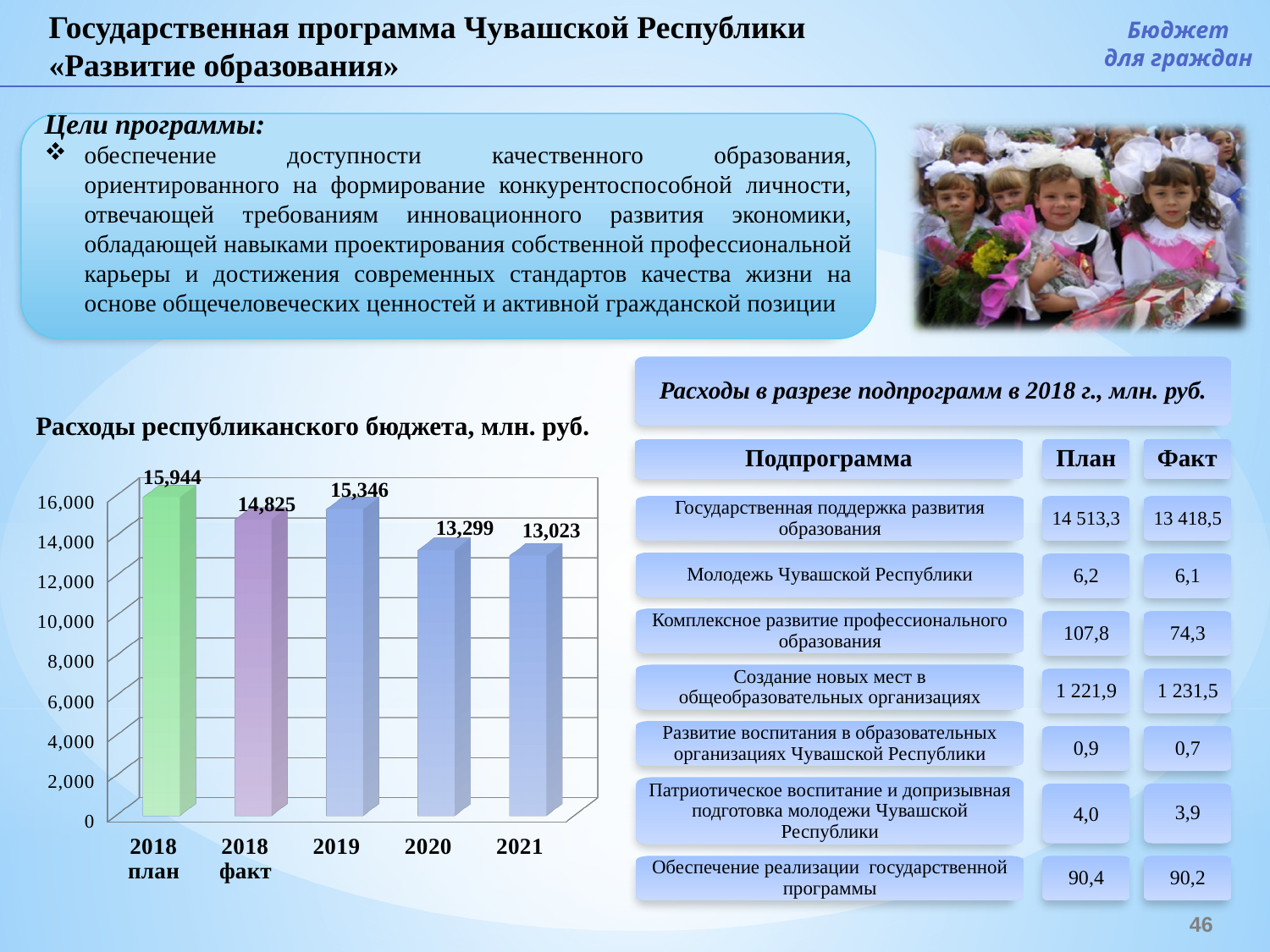
Which category has the lowest value in the chart? 2021 What is the value for 2019 in the chart? 15,346 What is the difference between the 2020 and 2021 values? 276 What is the difference between the 2018 план and 2018 факт values? 1,119 Which category has the highest value in the chart? 2018 план Is the value for 2020 greater or less than 14,000? less What is the value for 2018 план in the chart 'Расходы республиканского бюджета, млн. руб.'? 15,944 What is the value for 2021 in the chart? 13,023 What is the value for 2018 факт in the chart? 14,825 How many bars are shown in the chart? 5 What type of chart is used to show 'Расходы республиканского бюджета, млн. руб.'? bar chart Which is larger, the value for 2019 or the value for 2020? 2019